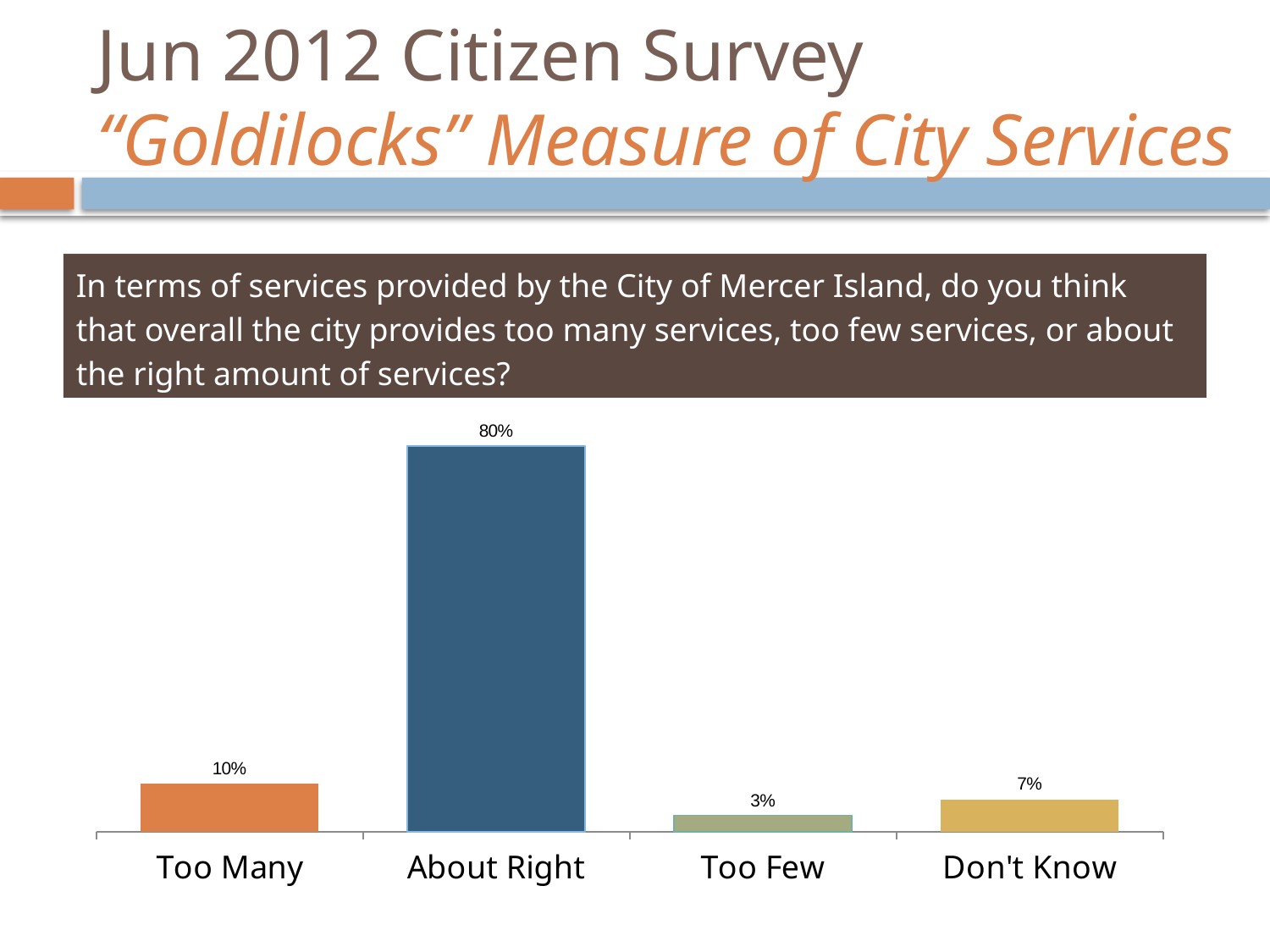
How many response categories are shown in the chart? 4 Which response category has the highest percentage? About Right Which response category has the lowest percentage? Too Few What percentage of respondents answered "Too Few"? 3% What is the difference in percentage points between "Too Many" and "Don't Know"? 3 What is the difference in percentage points between "About Right" and "Too Many"? 70 What type of chart is shown on the slide? Bar chart What percentage of respondents answered "Too Many"? 10% What percentage of respondents said the city provides about the right amount of services? 80% What colour is the bar for "About Right"? Blue Which is larger, the percentage for "Too Many" or for "Don't Know"? Too Many What percentage of respondents answered "Don't Know"? 7%